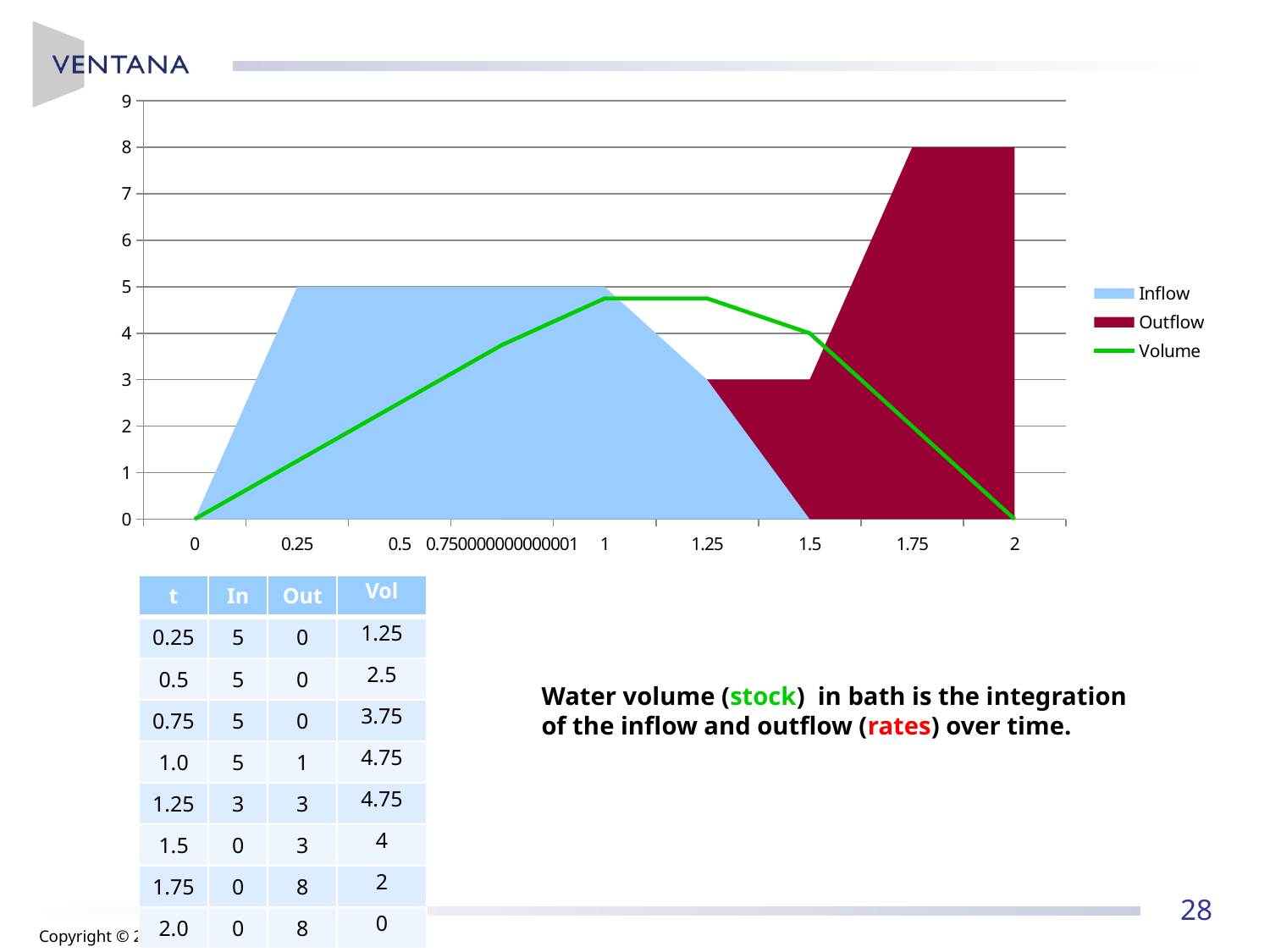
How many series does the legend list? 3 Is the Volume value at t = 0.75 greater or less than 4? less Does the Volume line rise or fall between t = 1.25 and t = 2? fall What is the difference between the Outflow and Inflow values at t = 1.75? 8 What colour is the Volume series in the legend? green What is the Inflow value at t = 0.5? 5 What kind of chart is shown on the slide? combination area and line chart Which series reaches the highest value on the chart? Outflow What is the Volume value at t = 1.5? 4 What is the Outflow value at t = 1.75? 8 What is the Volume value at t = 1.0? 4.75 At t = 1.5, which is larger, Inflow or Outflow? Outflow